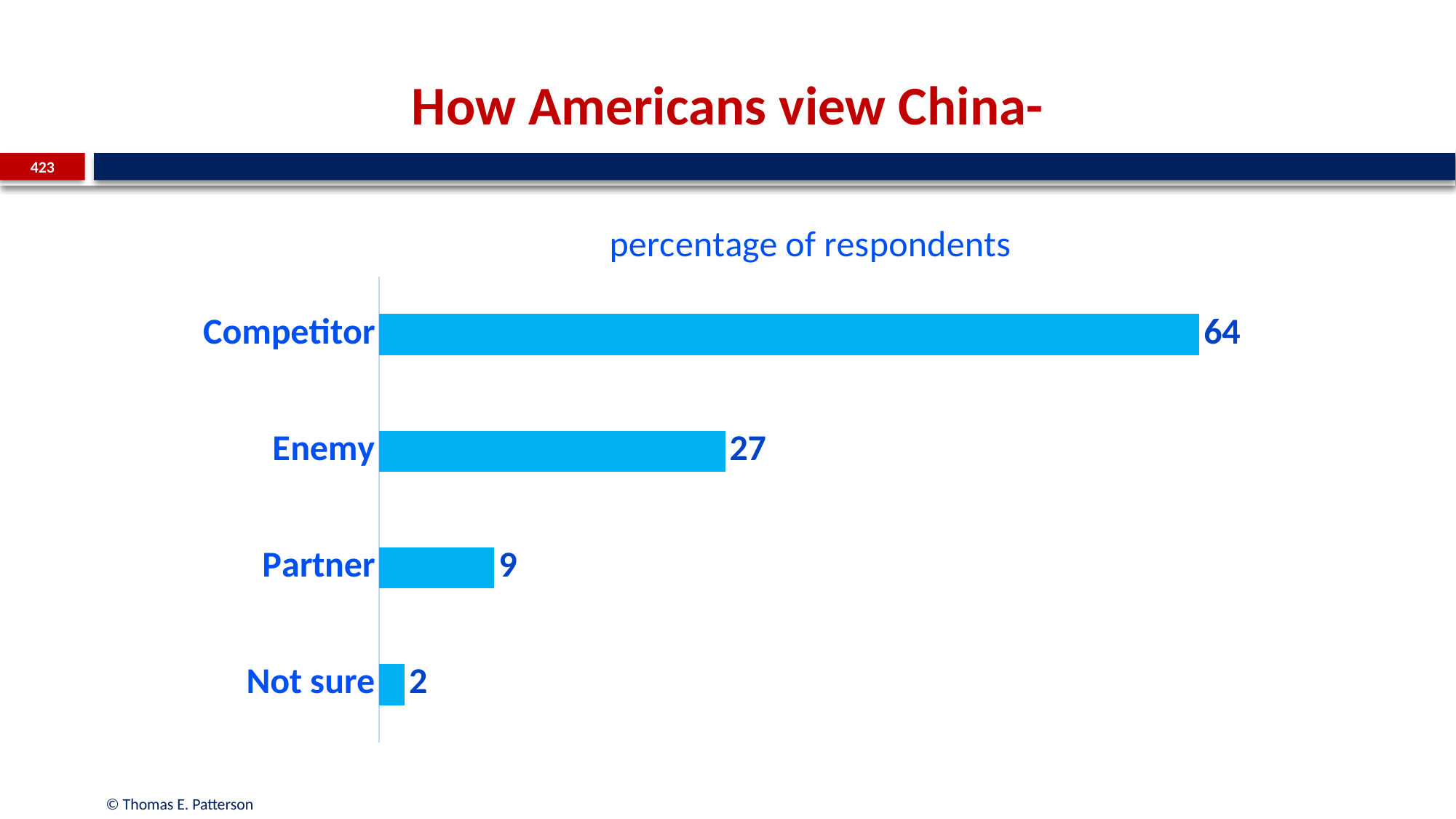
What is the title of the chart? percentage of respondents How many categories are shown in the chart? 4 What percentage of respondents answered 'Not sure'? 2 Which category has the highest percentage of respondents? Competitor What kind of chart is shown on the slide? Bar chart What percentage of respondents view China as a competitor? 64 What percentage of respondents view China as an enemy? 27 Which category has the lowest percentage of respondents? Not sure What is the difference between the percentage for Competitor and the percentage for Enemy? 37 What is the difference between the percentage for Enemy and the percentage for Partner? 18 Which is larger, the value for Partner or the value for Not sure? Partner What percentage of respondents view China as a partner? 9